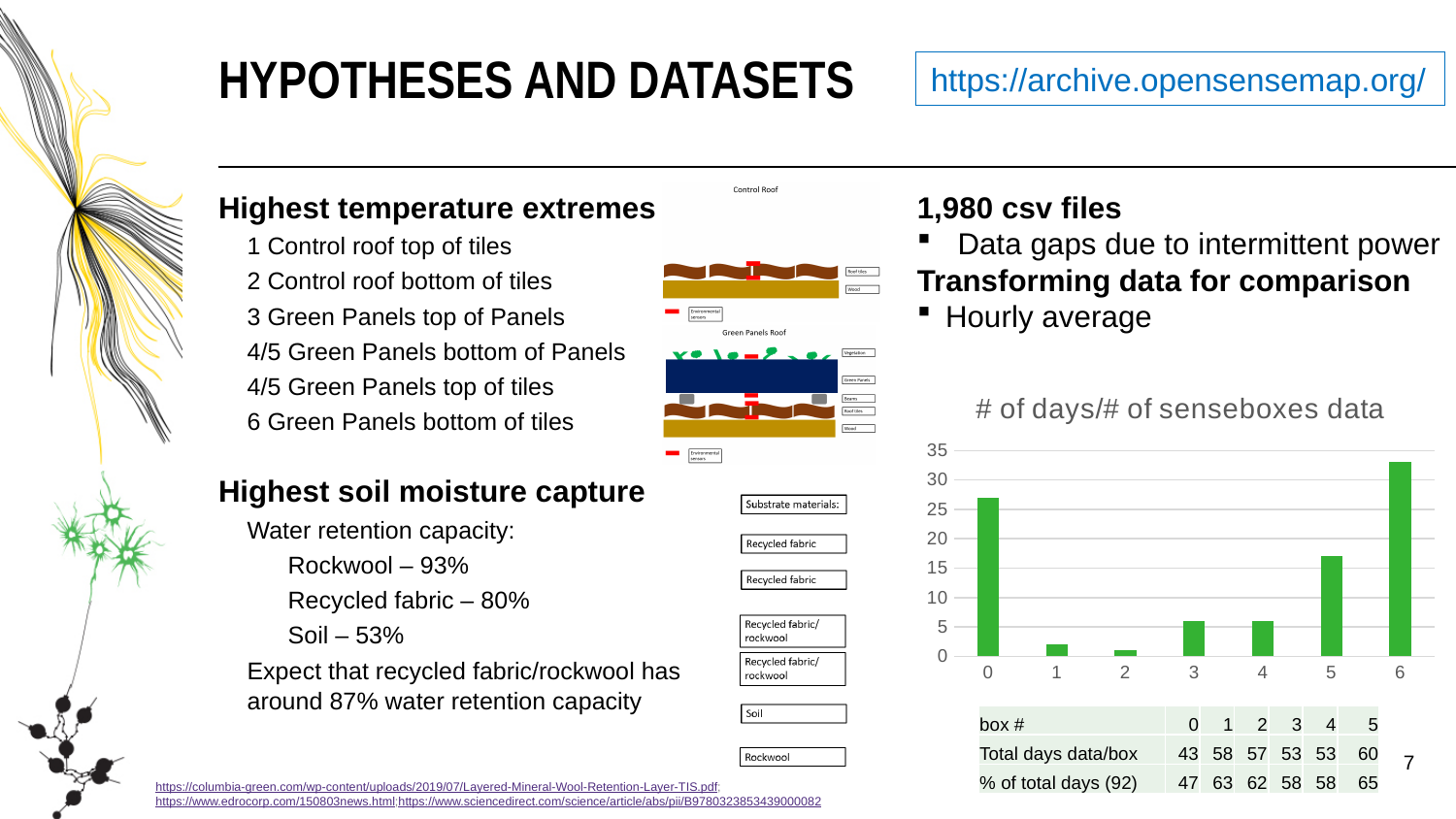
How many categories are shown on the x axis of the chart? 7 Is the value for category 0 greater or less than 25? greater What is the title of the chart? # of days/# of senseboxes data Which is larger, the value for category 0 or the value for category 5? 0 Is the value for category 1 greater or less than 5? less Is the value for category 3 greater or less than 10? less Which is larger, the value for category 5 or the value for category 6? 6 Which category has the highest bar in the chart? 6 What kind of chart is shown on the slide? bar chart